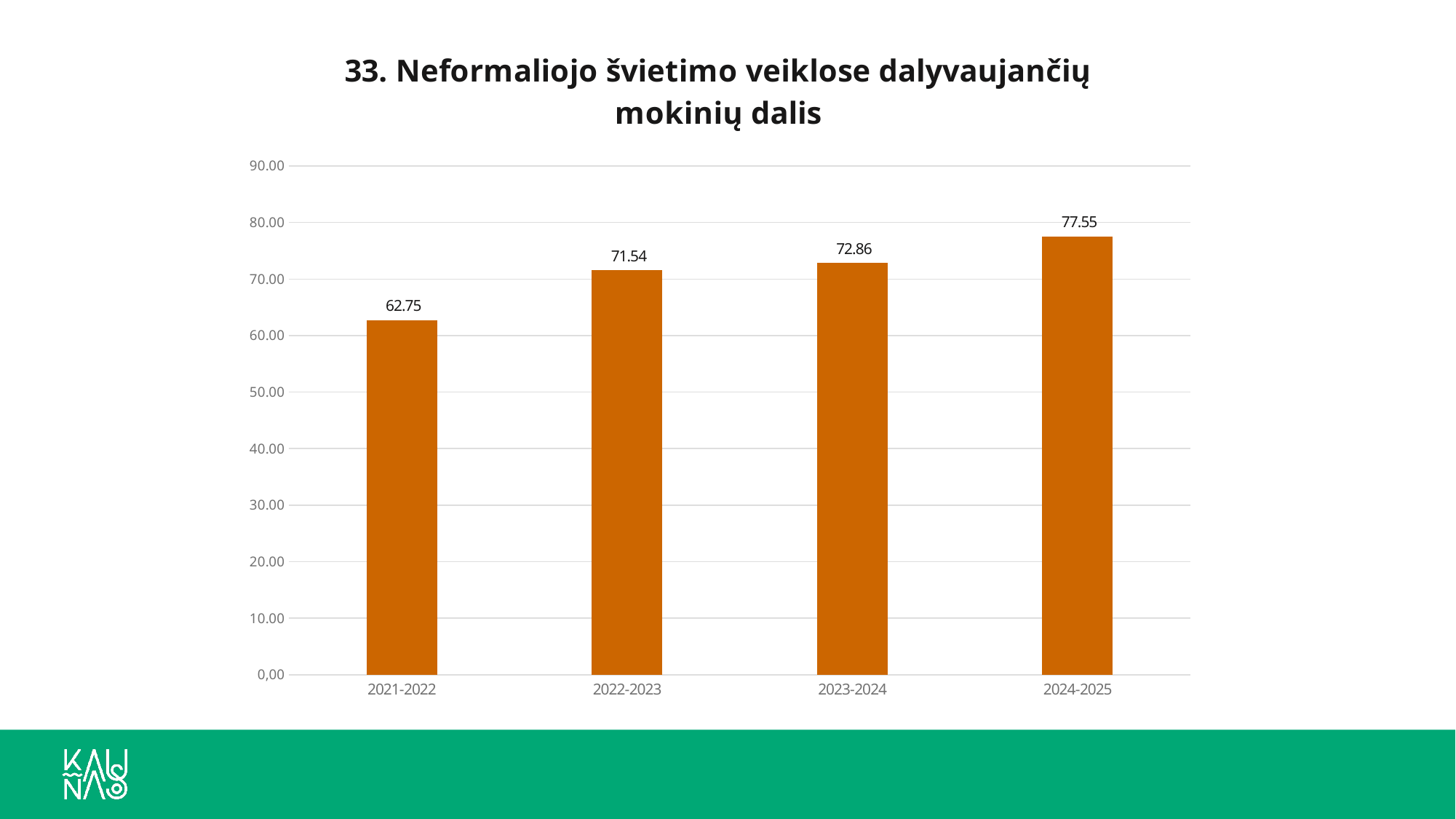
What is the value for 2023-2024? 72.86 Which is larger, the value for 2022-2023 or the value for 2024-2025? 2024-2025 What is the value for 2024-2025? 77.55 Which school year has the highest value? 2024-2025 What is the value for 2022-2023? 71.54 How many school years are shown on the x axis? 4 Which school year has the lowest value? 2021-2022 What is the value for 2021-2022? 62.75 What is the difference between the values for 2024-2025 and 2021-2022? 14.80 What kind of chart is shown on the slide? bar chart Is the value for 2021-2022 greater or less than 70.00? less Do the values rise or fall from 2021-2022 to 2024-2025? rise